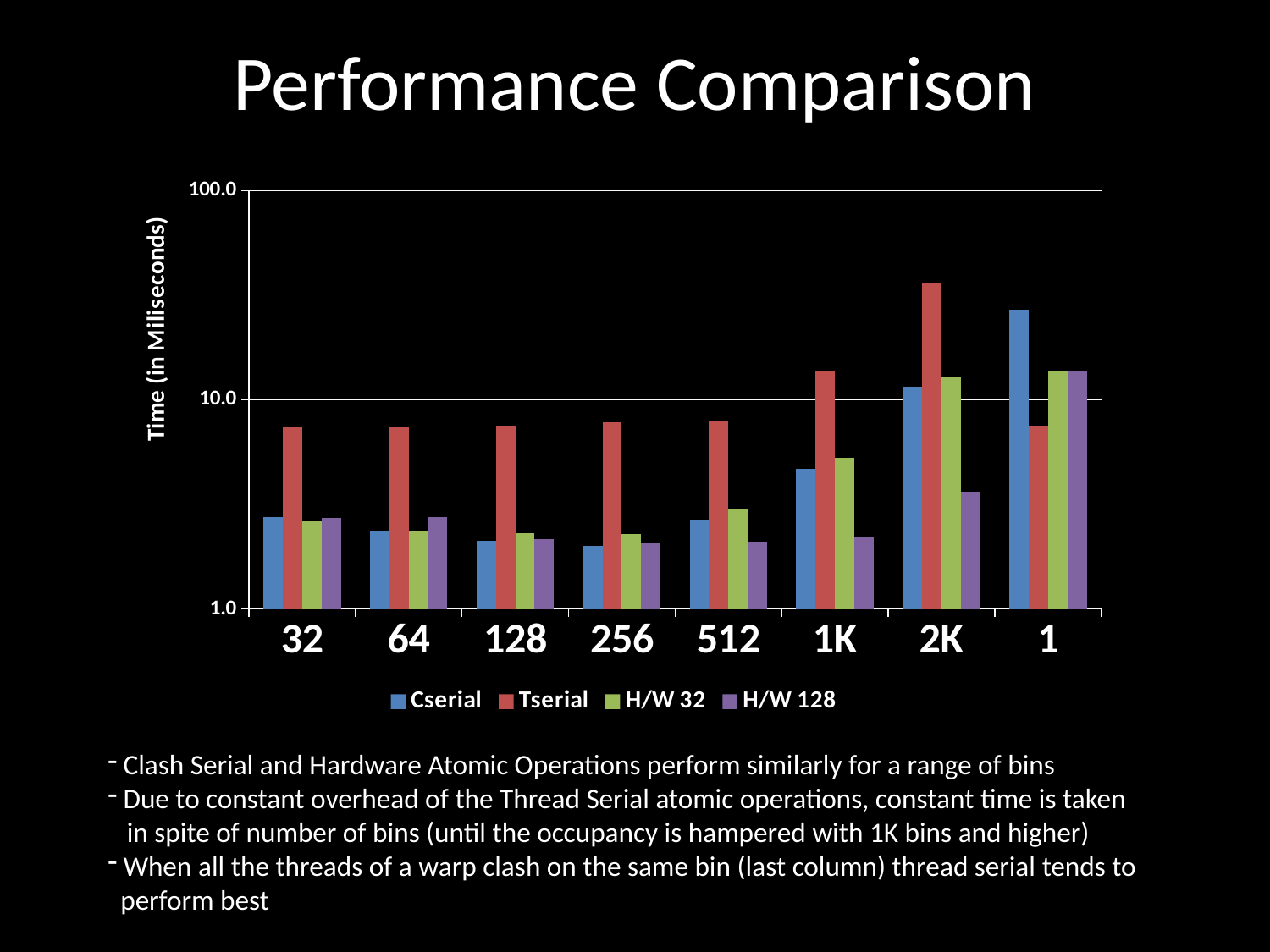
Which series has the lowest value for the 2K category? H/W 128 For which category is the Tserial bar the highest? 2K Is the H/W 128 value for 2K greater or less than 10.0? less For the category labelled 1, which is larger: Cserial or Tserial? Cserial For which category is the Cserial bar the highest? 1 For the 2K category, which is larger: Tserial or Cserial? Tserial Is the Cserial value for 32 greater or less than 10.0? less What is the title of the y axis? Time (in Miliseconds) What kind of chart is shown on the slide? bar chart How many series does the legend list? 4 Is the Tserial value for 2K greater or less than 10.0? greater How many categories are shown along the x axis? 8